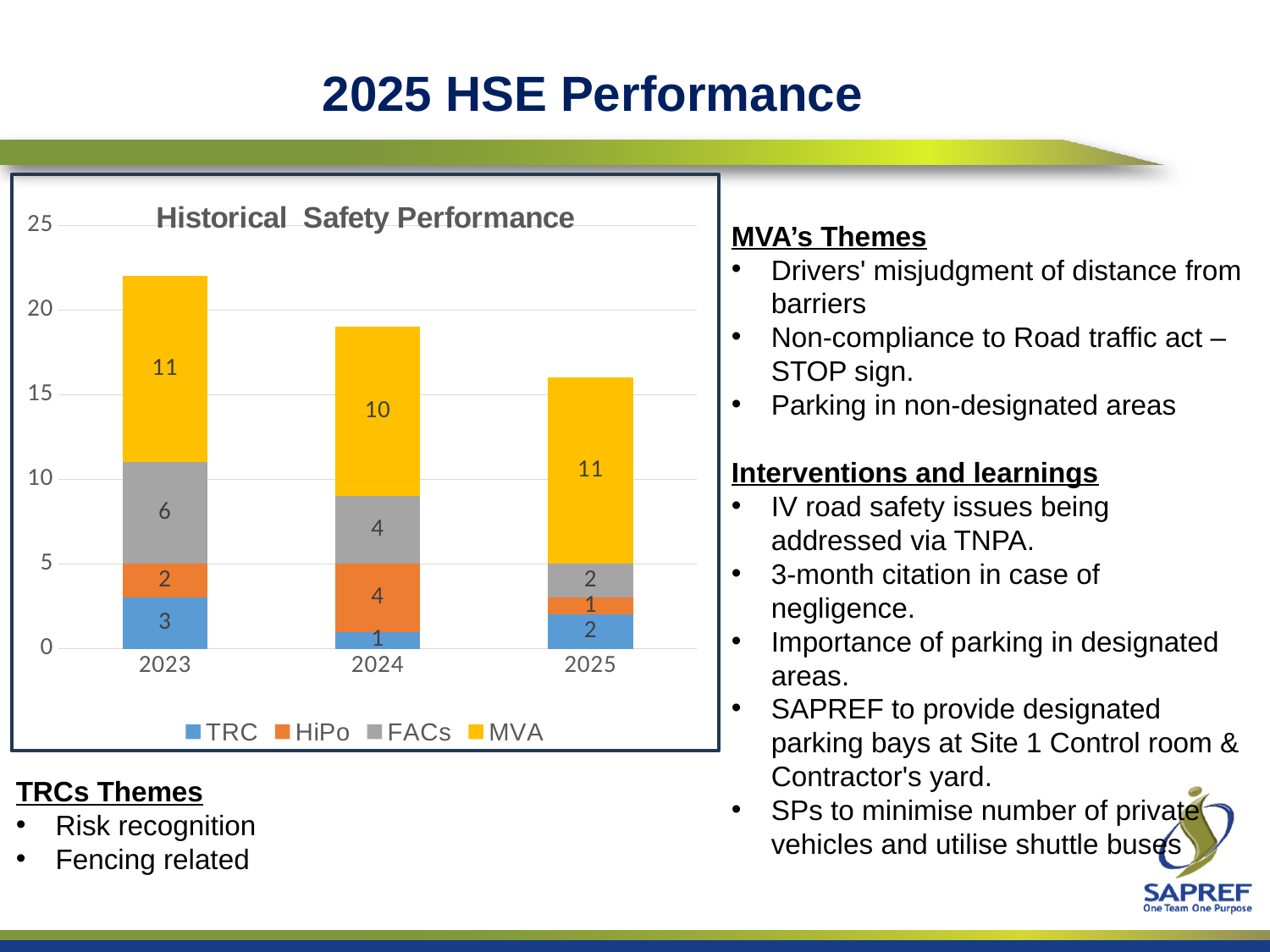
What is the FACs value for 2023? 6 What is the total of the stacked bar for 2023? 22 What is the difference between the HiPo values for 2024 and 2023? 2 How many years are shown on the x axis of the chart? 3 Is the total of the stacked bar for 2025 greater or less than 15? greater What type of chart is shown on the slide? Stacked bar chart What is the MVA value for 2024? 10 Which year has the lowest FACs value? 2025 What is the title of the chart? Historical Safety Performance What is the HiPo value for 2025? 1 How many series does the chart legend list? 4 Which year has the highest TRC value? 2023